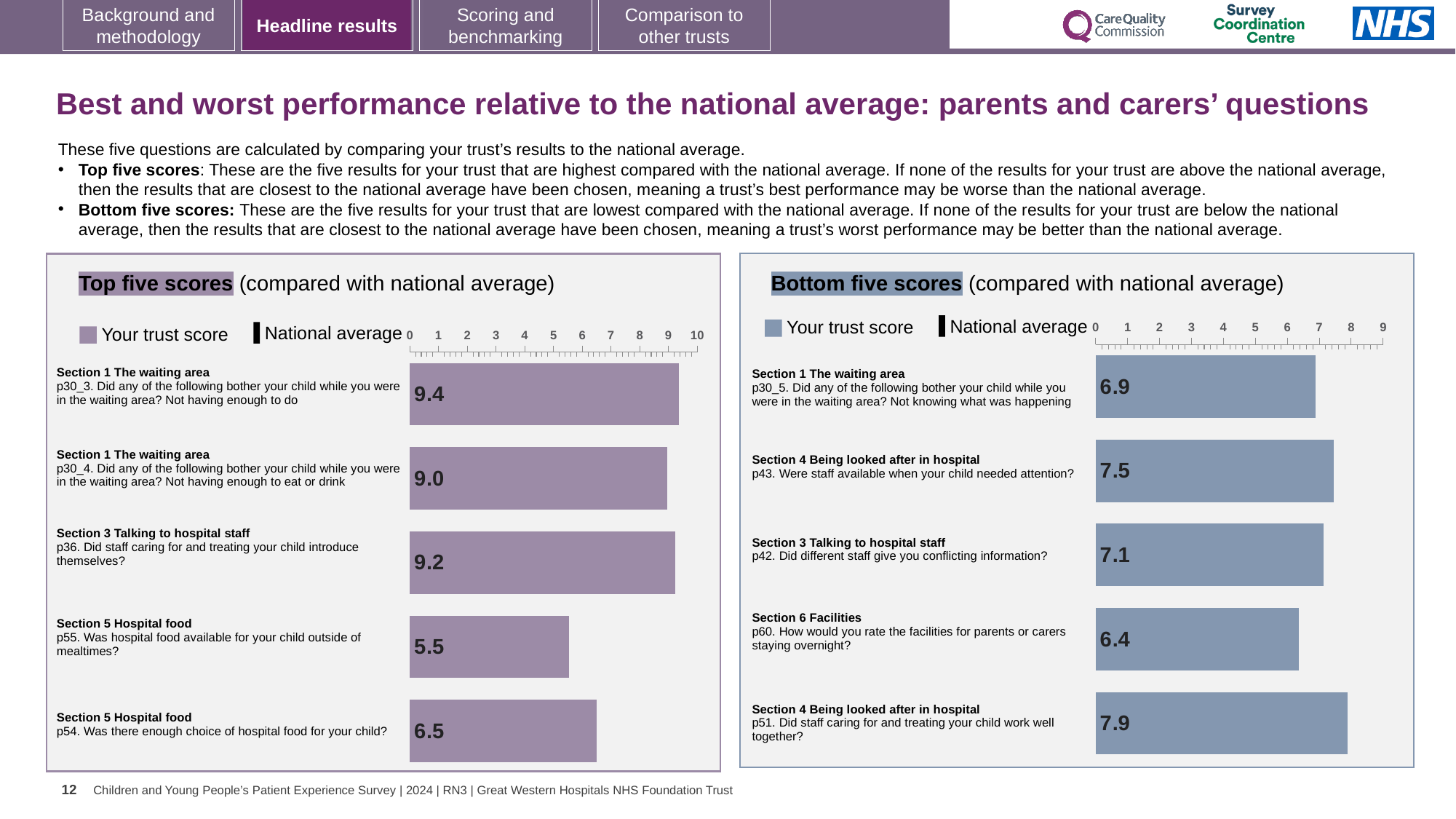
What type of chart is the Top five scores chart? Bar chart In the Top five scores chart, which has the larger trust score: p36 (Did staff introduce themselves) or p30_4 (Not having enough to eat or drink)? p36. Did staff caring for and treating your child introduce themselves? How many questions are shown in the Bottom five scores chart? 5 In the Bottom five scores chart, what is the trust score for p60 (How would you rate the facilities for parents or carers staying overnight)? 6.4 In the Top five scores chart, what is the trust score for p30_3 (Not having enough to do in the waiting area)? 9.4 In the Bottom five scores chart, what is the difference between the trust scores for p51 and p60? 1.5 In the Top five scores chart, which question has the lowest trust score? p55. Was hospital food available for your child outside of mealtimes? In the Bottom five scores chart, which question has the lowest trust score? p60. How would you rate the facilities for parents or carers staying overnight? In the Top five scores chart, what is the trust score for p54 (Was there enough choice of hospital food for your child)? 6.5 In the Bottom five scores chart, what is the trust score for p51 (Did staff caring for and treating your child work well together)? 7.9 In the Top five scores chart, which question has the highest trust score? p30_3. Did any of the following bother your child while you were in the waiting area? Not having enough to do How many entries does the legend of the Bottom five scores chart list? 2